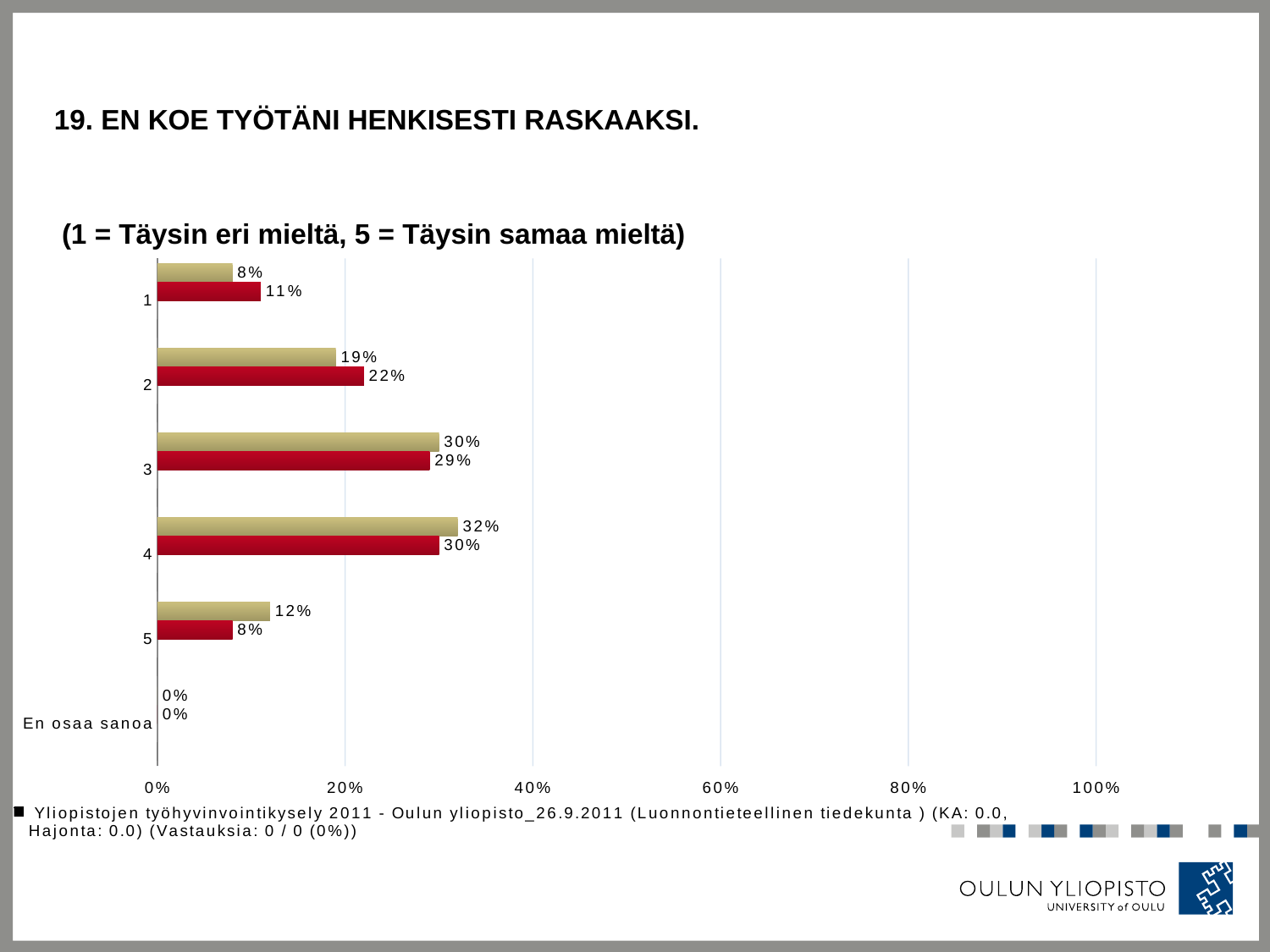
What is the value shown for the category 'En osaa sanoa'? 0% Which category has the lowest value for the tan bars? En osaa sanoa What is the value of the tan bar for category 1? 8% Is the value of the tan bar for category 3 greater or less than 20%? greater How many categories are shown on the vertical axis of the chart? 6 What is the value of the red bar for category 5? 8% What is the value of the tan bar for category 4? 32% What is the value of the red bar for category 2? 22% What type of chart is shown on the slide? bar chart Which category has the highest value for the red bars? 4 For category 2, which bar is larger, the tan bar or the red bar? the red bar What is the difference between the tan bar and the red bar for category 5? 4%